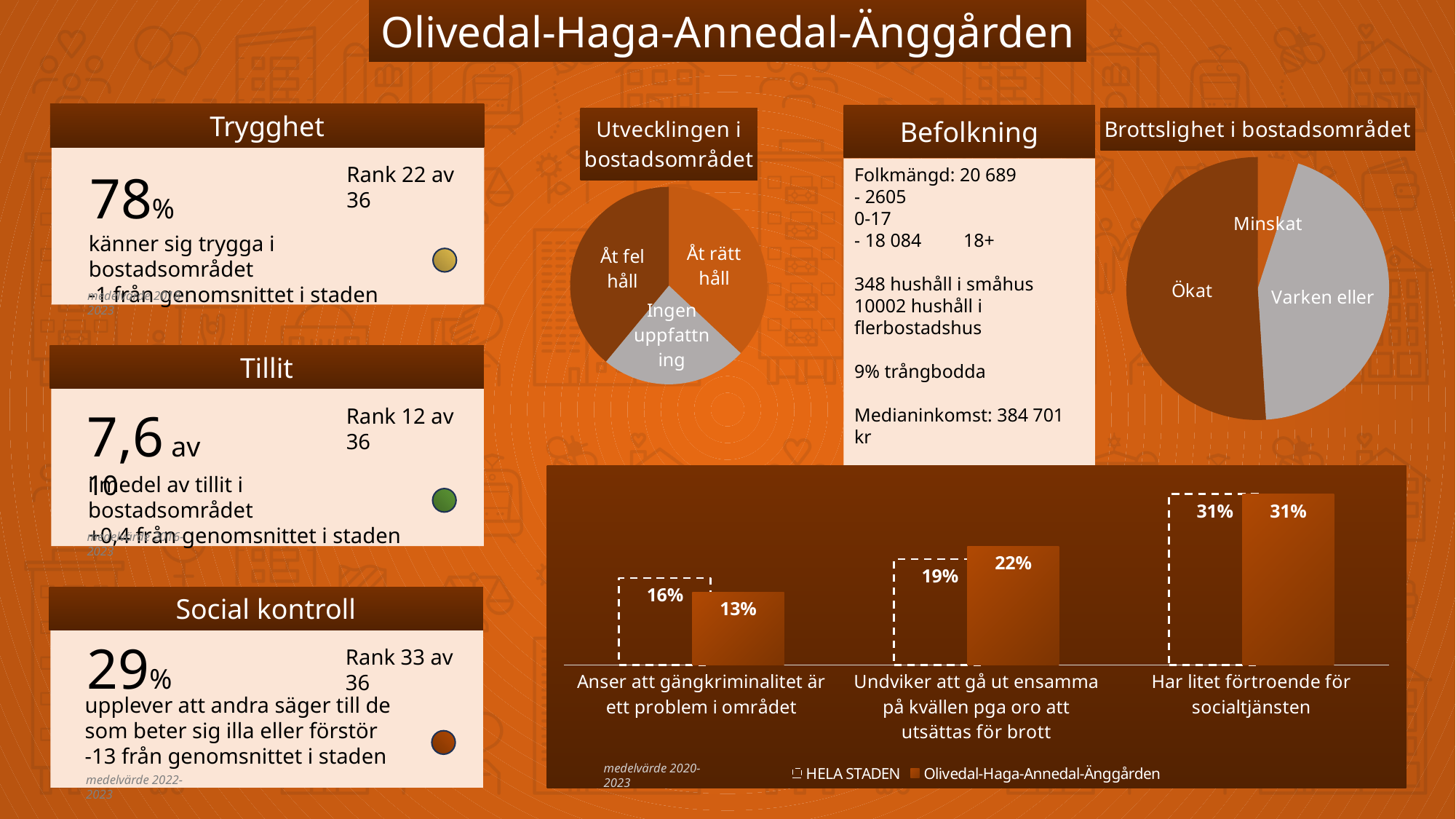
In the bar chart at the bottom, which category has the lowest value for HELA STADEN? Anser att gängkriminalitet är ett problem i området In the bar chart at the bottom, how many series does the legend list? 2 In the bar chart at the bottom, which category has the highest value for Olivedal-Haga-Annedal-Änggården? Har litet förtroende för socialtjänsten In the bar chart at the bottom, which is larger for 'Anser att gängkriminalitet är ett problem i området': HELA STADEN or Olivedal-Haga-Annedal-Änggården? HELA STADEN In the bar chart at the bottom, how many categories are shown on the x axis? 3 In the bar chart at the bottom, what is the difference between HELA STADEN and Olivedal-Haga-Annedal-Änggården for 'Undviker att gå ut ensamma på kvällen pga oro att utsättas för brott'? 3% In the 'Brottslighet i bostadsområdet' pie chart, which slice is the smallest? Minskat In the bar chart at the bottom, what is the value for HELA STADEN for 'Undviker att gå ut ensamma på kvällen pga oro att utsättas för brott'? 19% In the bar chart at the bottom, what is the value for Olivedal-Haga-Annedal-Änggården for 'Anser att gängkriminalitet är ett problem i området'? 13% In the bar chart at the bottom, what is the value for Olivedal-Haga-Annedal-Änggården for 'Har litet förtroende för socialtjänsten'? 31% In the 'Utvecklingen i bostadsområdet' pie chart, which slice is the smallest? Ingen uppfattning What kind of chart is the 'Utvecklingen i bostadsområdet' chart? Pie chart